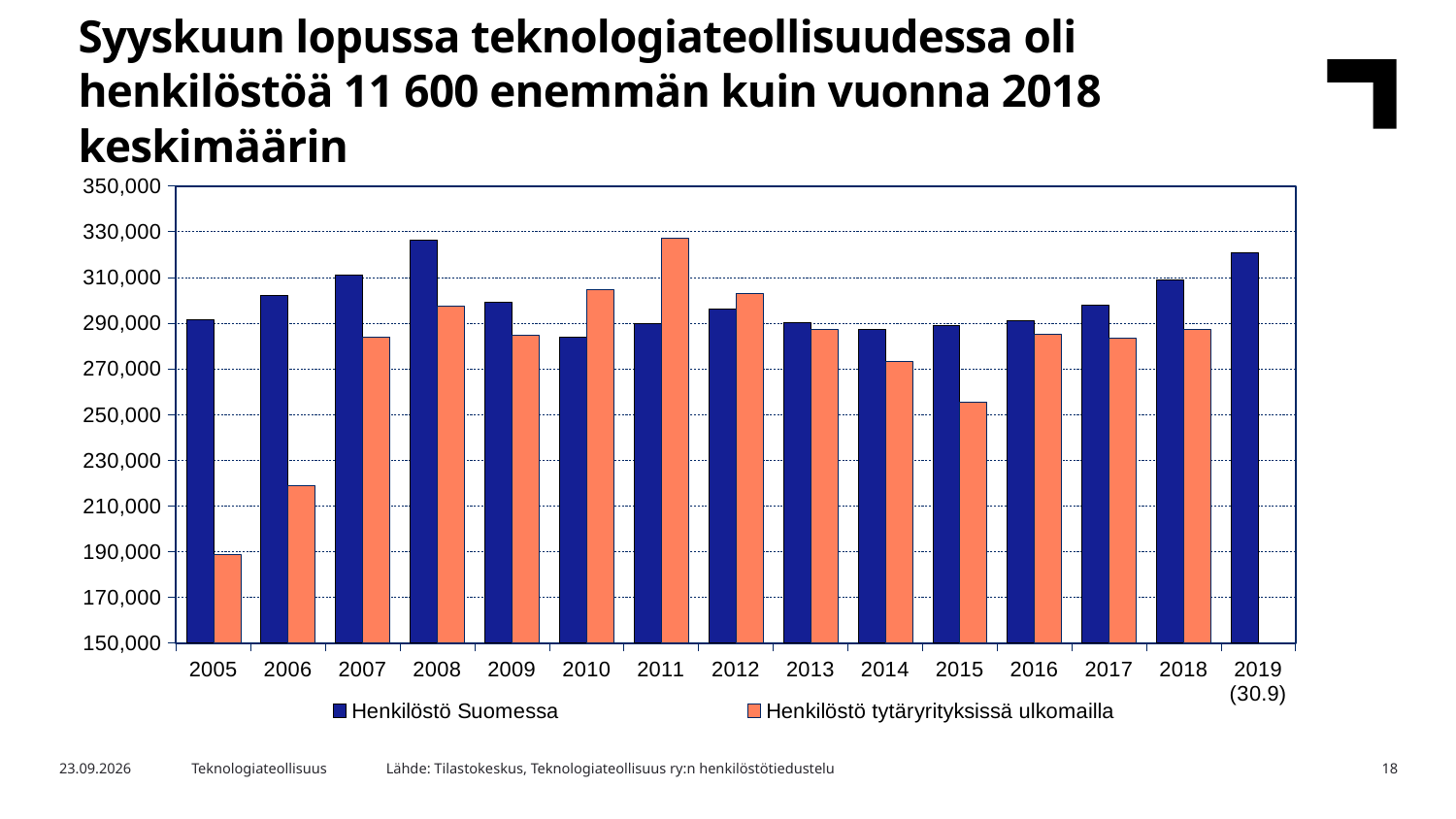
Which colour represents Henkilöstö Suomessa in the legend? dark blue Does the value for Henkilöstö tytäryrityksissä ulkomailla rise or fall from 2005 to 2011? rise How many series does the legend list? 2 In which year is the value for Henkilöstö Suomessa highest? 2008 What kind of chart is shown on the slide? bar chart In 2006, which is larger: Henkilöstö Suomessa or Henkilöstö tytäryrityksissä ulkomailla? Henkilöstö Suomessa Is the value for Henkilöstö Suomessa in 2019 (30.9) greater or less than 310,000? greater Is the value for Henkilöstö tytäryrityksissä ulkomailla in 2015 greater or less than 250,000? greater In which year is the value for Henkilöstö tytäryrityksissä ulkomailla lowest? 2005 How many year categories are shown on the x axis? 15 In which year is the value for Henkilöstö tytäryrityksissä ulkomailla highest? 2011